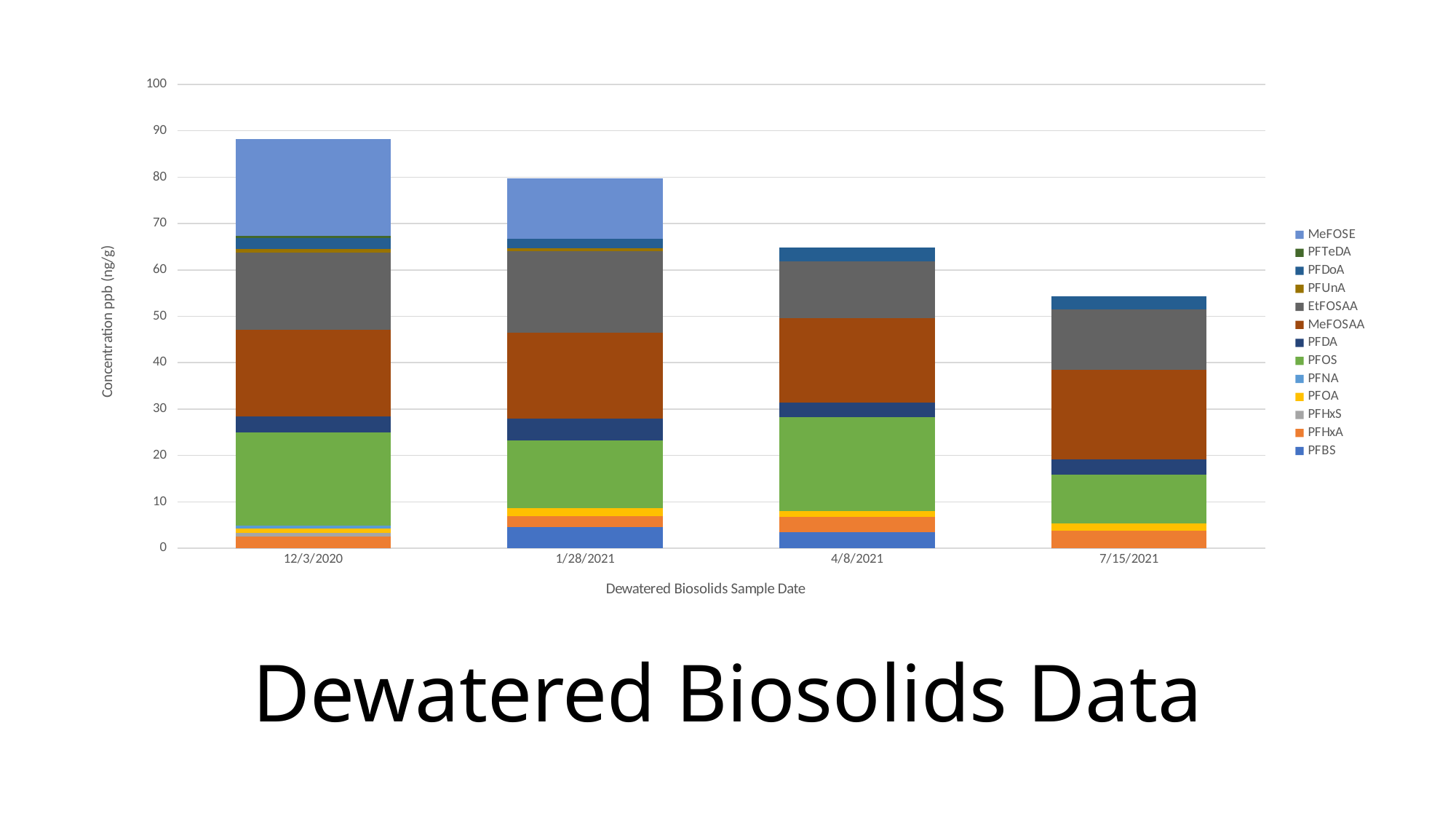
Is the total stacked value for 12/3/2020 greater or less than 80? greater Do the total bar heights rise or fall from 12/3/2020 to 7/15/2021? Fall Which has the larger total stacked bar, 1/28/2021 or 4/8/2021? 1/28/2021 How many sample dates are shown on the x axis? 4 What is the title of the x axis? Dewatered Biosolids Sample Date Which sample date has the highest total stacked bar? 12/3/2020 Is the total stacked value for 4/8/2021 greater or less than 70? less How many series does the legend list? 13 Is the total stacked value for 7/15/2021 greater or less than 60? less What is the title of the y axis? Concentration ppb (ng/g) Which sample date has the lowest total stacked bar? 7/15/2021 What kind of chart is shown on the slide? Stacked bar chart